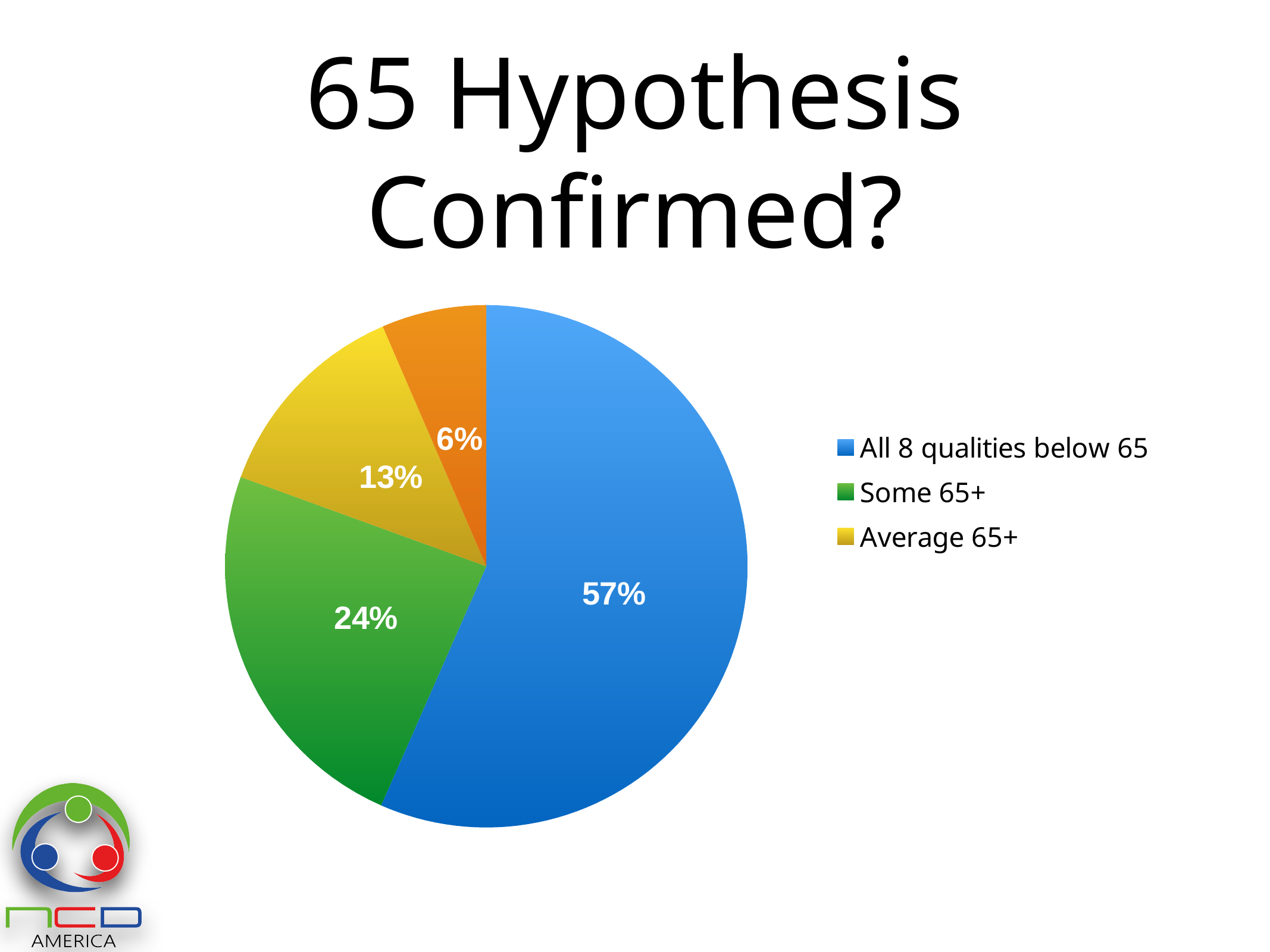
Which is larger, the 'Some 65+' slice or the 'Average 65+' slice? Some 65+ How many slices does the pie chart have? 4 What percentage of the pie is labelled for 'All 8 qualities below 65'? 57% What percentage of the pie is labelled for 'Some 65+'? 24% How many entries does the legend list? 3 Which category has the largest slice of the pie? All 8 qualities below 65 What type of chart is shown on the slide? Pie chart What colour is the slice for 'All 8 qualities below 65'? Blue What is the difference between the 'All 8 qualities below 65' slice and the 'Some 65+' slice? 33% What percentage of the pie is labelled for 'Average 65+'? 13% What is the difference between the 'Some 65+' slice and the 'Average 65+' slice? 11% What is the value of the smallest slice in the pie chart? 6%